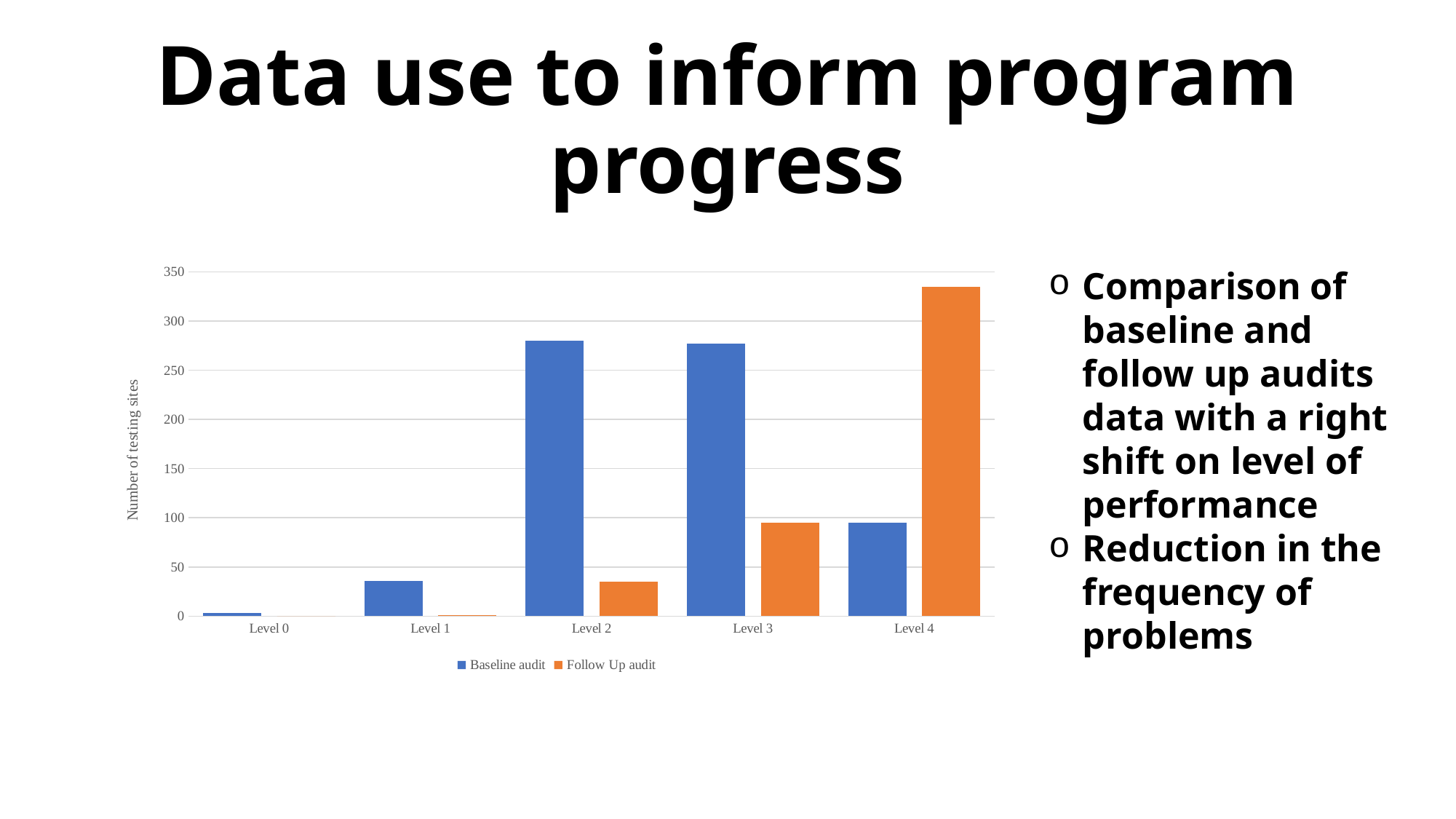
Which level has the lowest Baseline audit value? Level 0 Is the Follow Up audit value for Level 4 greater or less than 300? greater Which level has the highest Follow Up audit value? Level 4 At Level 4, which series has the larger value, Baseline audit or Follow Up audit? Follow Up audit Is the Baseline audit value for Level 4 greater or less than 150? less Is the Baseline audit value for Level 1 greater or less than 50? less How many level categories are shown on the x axis of the chart? 5 At Level 2, which series has the larger value, Baseline audit or Follow Up audit? Baseline audit What is the label of the vertical axis of the chart? Number of testing sites How many series does the chart legend list? 2 What kind of chart is shown on the slide? bar chart